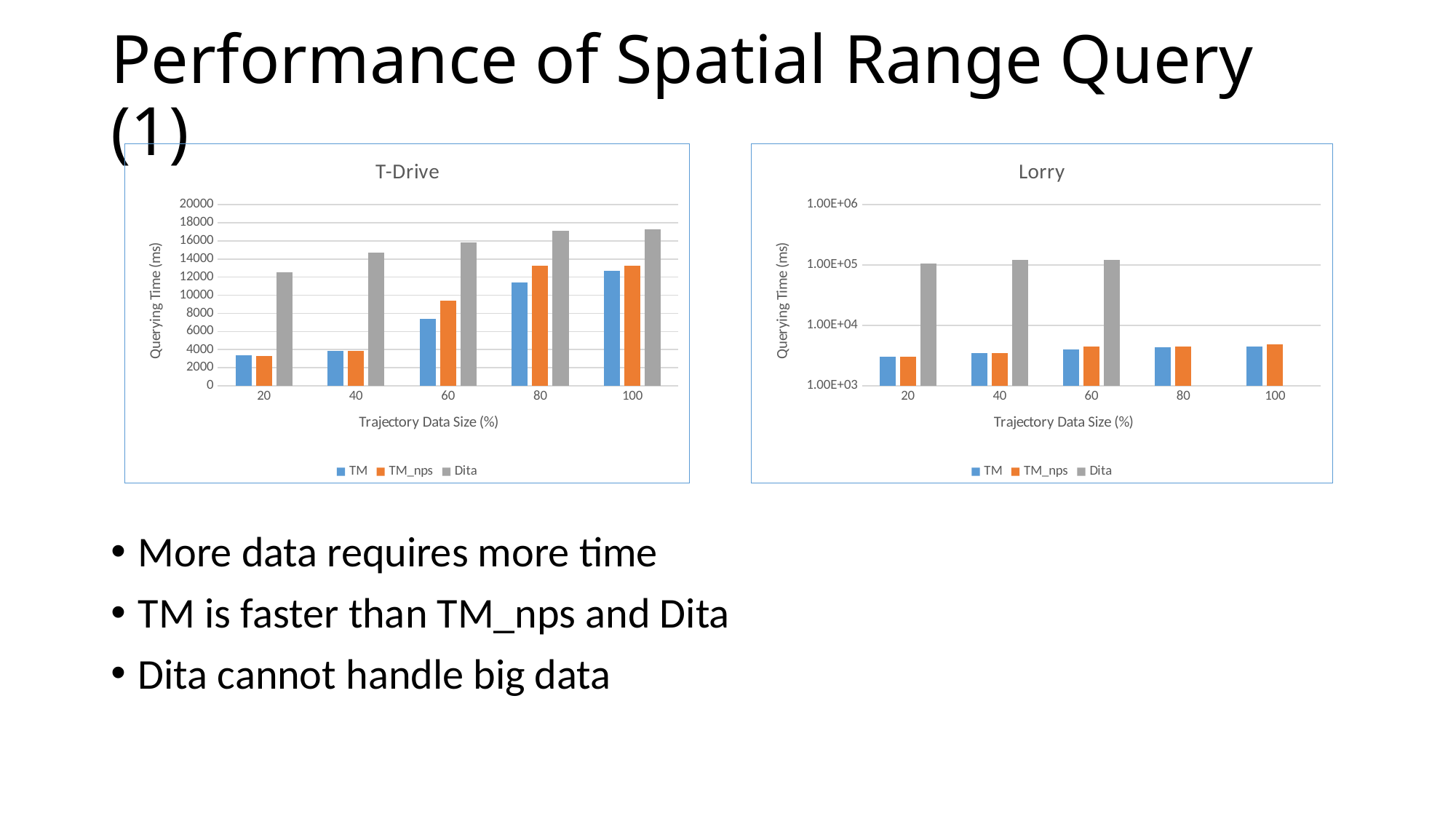
In the T-Drive chart, which series has the lowest querying time at a data size of 60? TM What kind of chart is the T-Drive chart? bar chart In the T-Drive chart, at a data size of 60, which is larger: the querying time for TM or for TM_nps? TM_nps In the Lorry chart, is the querying time for TM at a data size of 20 greater or less than 1.00E+04? less In the T-Drive chart, is the querying time for TM at a data size of 20 greater or less than 4000? less In the T-Drive chart, does the querying time for TM rise or fall as the trajectory data size increases? rise How many trajectory data size categories are shown on the x axis of the T-Drive chart? 5 In the T-Drive chart, which series has the highest querying time at a data size of 100? Dita In the Lorry chart, at a data size of 60, which is larger: the querying time for Dita or for TM? Dita In the Lorry chart, which series has no bars at data sizes 80 and 100? Dita How many series does the legend of the Lorry chart list? 3 In the T-Drive chart, is the querying time for Dita at a data size of 100 greater or less than 16000? greater